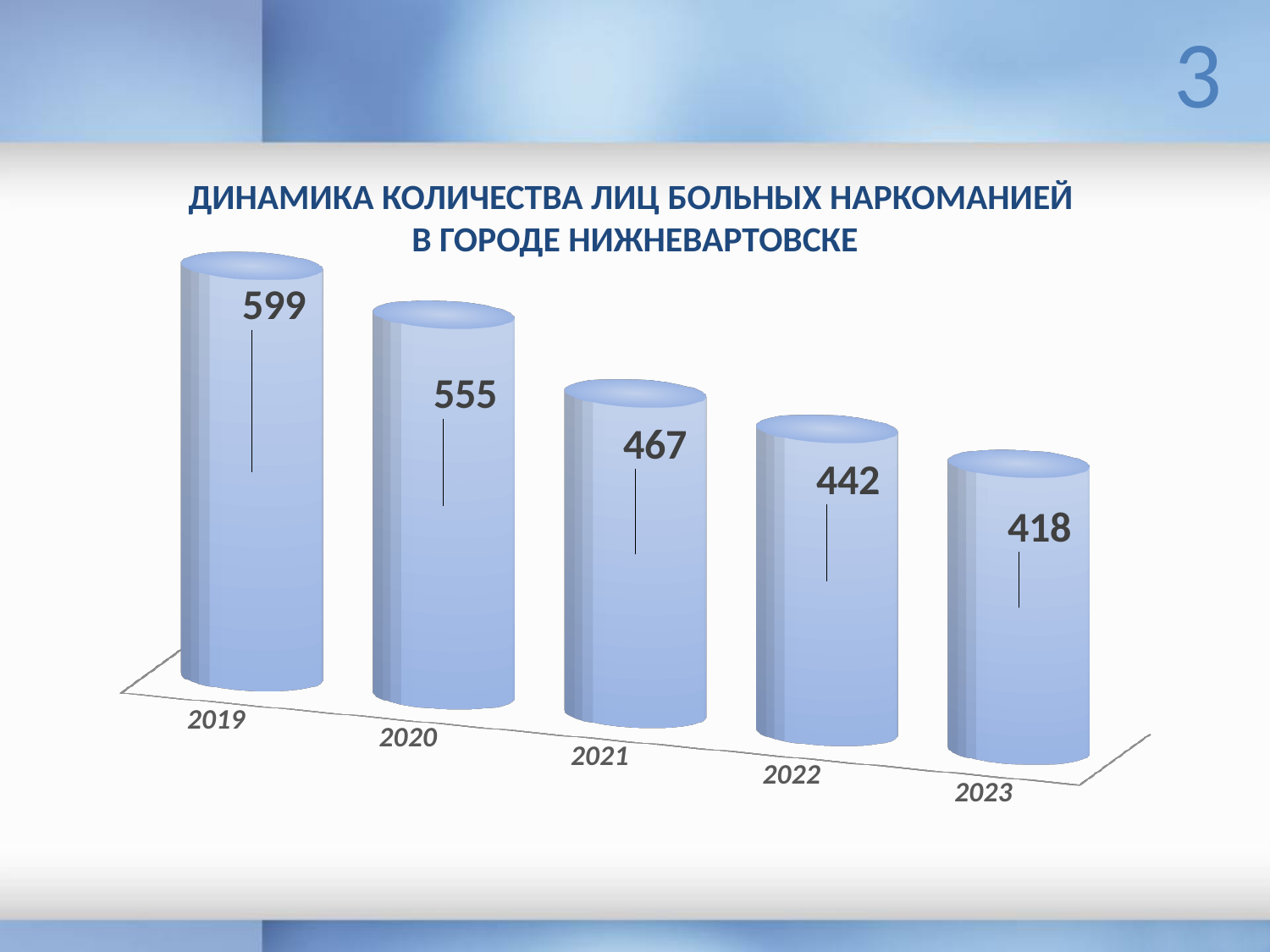
How many years are shown on the chart? 5 What is the difference between the values for 2022 and 2023? 24 What kind of chart is shown on the slide? Bar chart What is the value for 2021? 467 What is the title of the chart? ДИНАМИКА КОЛИЧЕСТВА ЛИЦ БОЛЬНЫХ НАРКОМАНИЕЙ В ГОРОДЕ НИЖНЕВАРТОВСКЕ Do the values rise or fall from 2019 to 2023? Fall What is the value for 2023? 418 What is the value for 2019? 599 Which year has the highest value? 2019 Which is larger, the value for 2020 or the value for 2021? 2020 What is the difference between the values for 2019 and 2020? 44 Which year has the lowest value? 2023